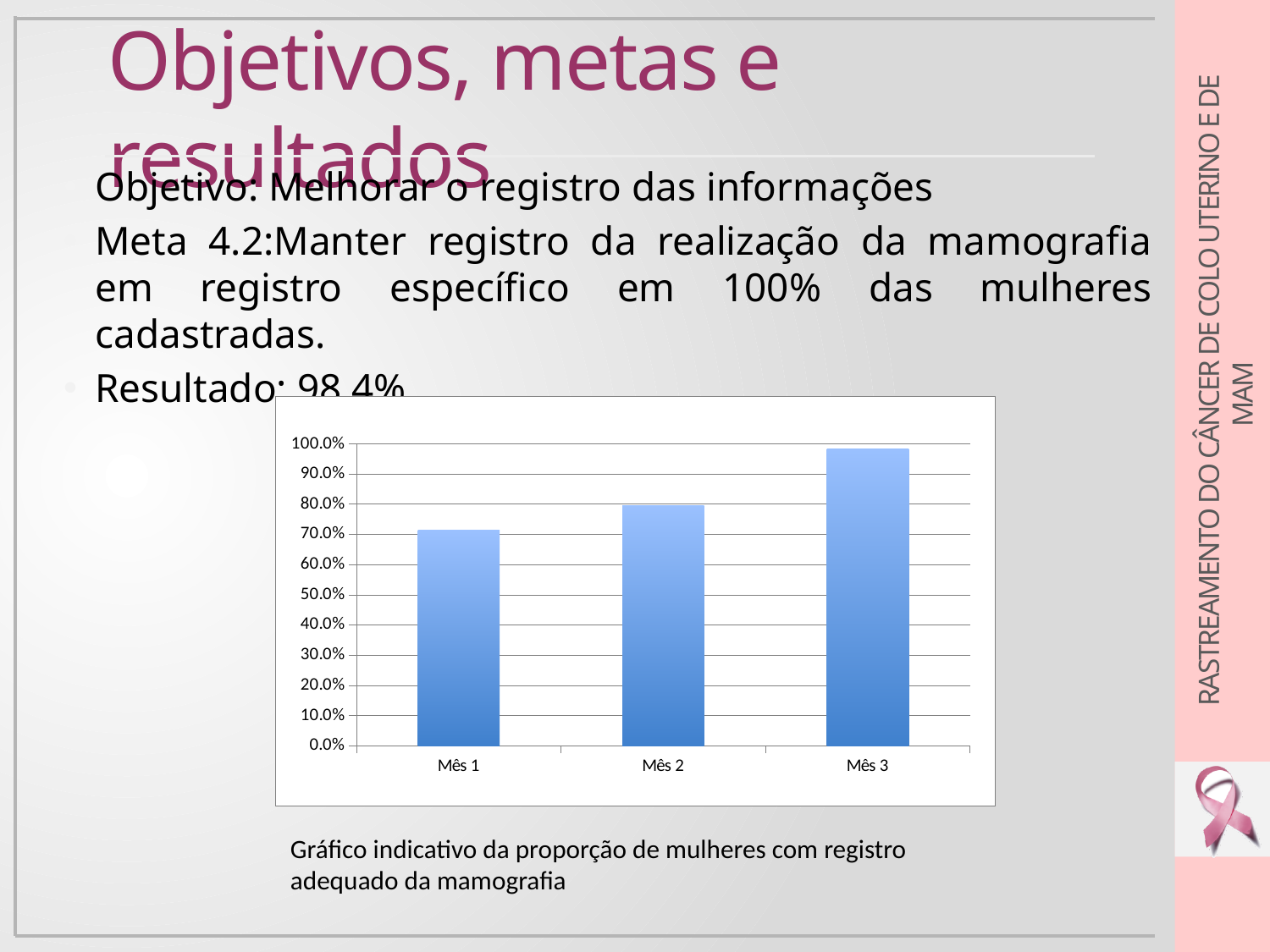
What is the caption written below the chart? Gráfico indicativo da proporção de mulheres com registro adequado da mamografia Is the value for Mês 1 greater or less than 60.0%? greater Which category has the highest bar in the chart? Mês 3 Is the value for Mês 1 greater or less than 80.0%? less Is the value for Mês 3 greater or less than 90.0%? greater Which is larger, the value for Mês 2 or the value for Mês 3? Mês 3 Which category has the lowest bar in the chart? Mês 1 How many categories are shown on the x axis of the chart? 3 What is the highest tick value shown on the y axis of the chart? 100.0% Do the values rise or fall from Mês 1 to Mês 3? rise What kind of chart is shown on the slide? bar chart